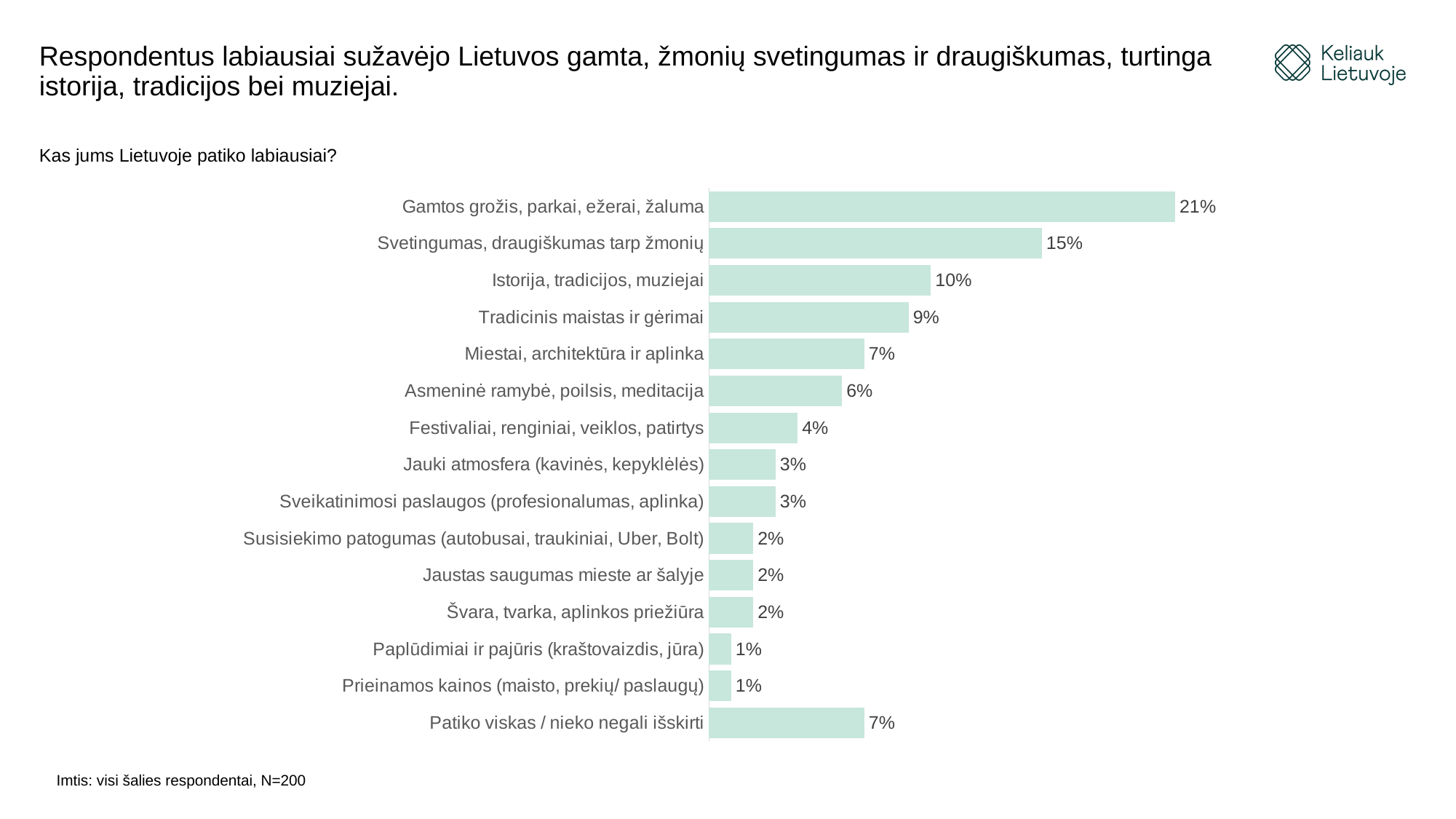
Which category has the highest value in the chart? Gamtos grožis, parkai, ežerai, žaluma How many categories are shown in the chart? 15 What percentage of respondents chose "Gamtos grožis, parkai, ežerai, žaluma"? 21% What is the sample size stated below the chart? N=200 What type of chart is shown on the slide? Bar chart Which is larger: the value for "Tradicinis maistas ir gėrimai" or for "Miestai, architektūra ir aplinka"? Tradicinis maistas ir gėrimai What value is shown for "Festivaliai, renginiai, veiklos, patirtys"? 4% What is the value shown for "Svetingumas, draugiškumas tarp žmonių"? 15% What value is shown for "Istorija, tradicijos, muziejai"? 10% What percentage is shown for "Patiko viskas / nieko negali išskirti"? 7% What is the difference between the values for "Gamtos grožis, parkai, ežerai, žaluma" and "Svetingumas, draugiškumas tarp žmonių"? 6 percentage points What is the lowest value shown in the chart? 1%